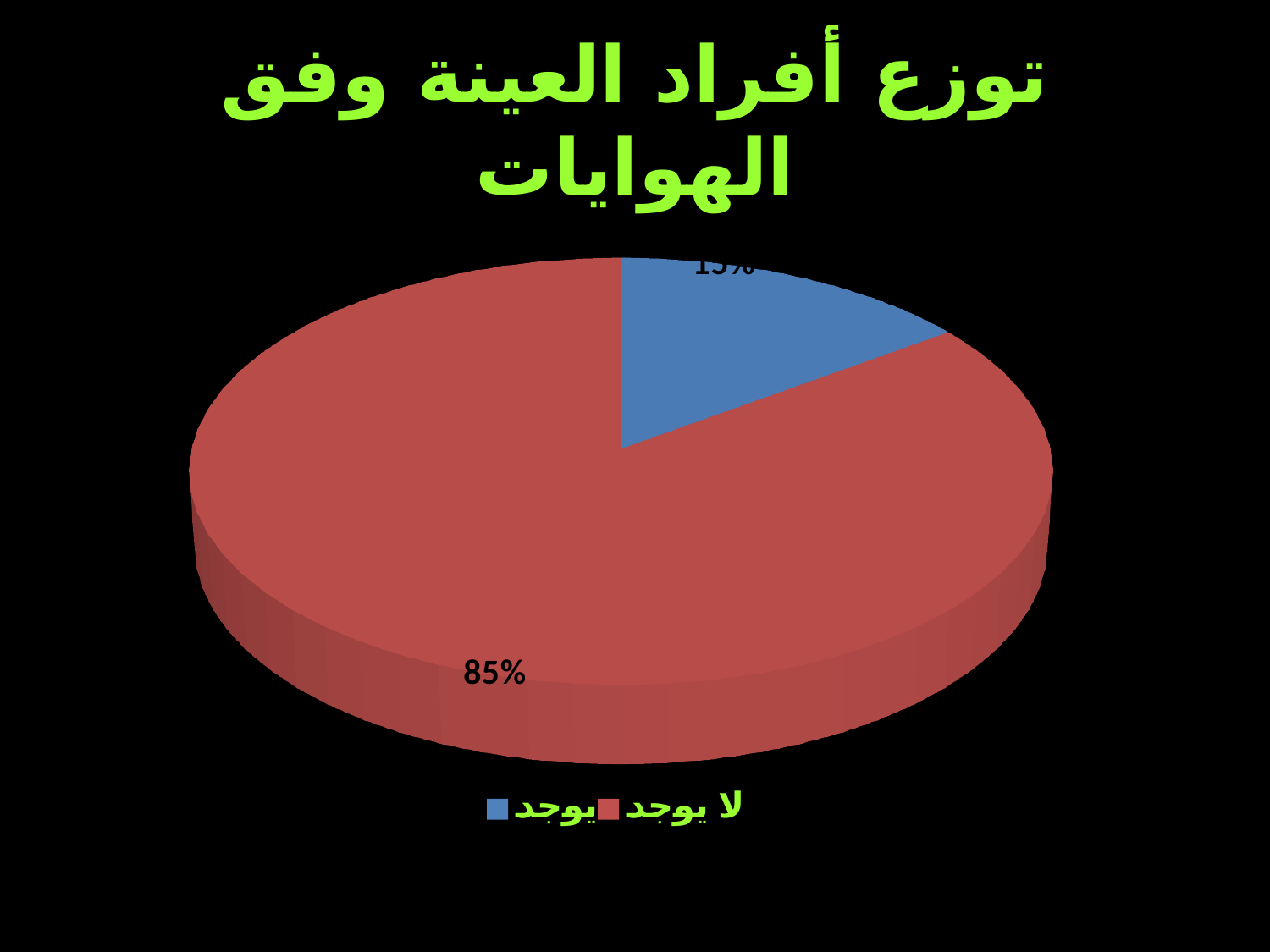
Which category has the smallest slice of the pie? يوجد What share of the pie does the "يوجد" slice represent? 15% How many categories does the legend list? 2 What share of the pie does the "لا يوجد" slice represent? 85% What is the title of the chart? توزع أفراد العينة وفق الهوايات What kind of chart is shown on the slide? pie chart Which category has the largest slice of the pie? لا يوجد Which is larger, the share for "لا يوجد" or the share for "يوجد"? لا يوجد What colour is the "لا يوجد" slice? red Is the share for "لا يوجد" greater or less than 50%? greater What is the difference in percentage points between the "لا يوجد" slice and the "يوجد" slice? 70